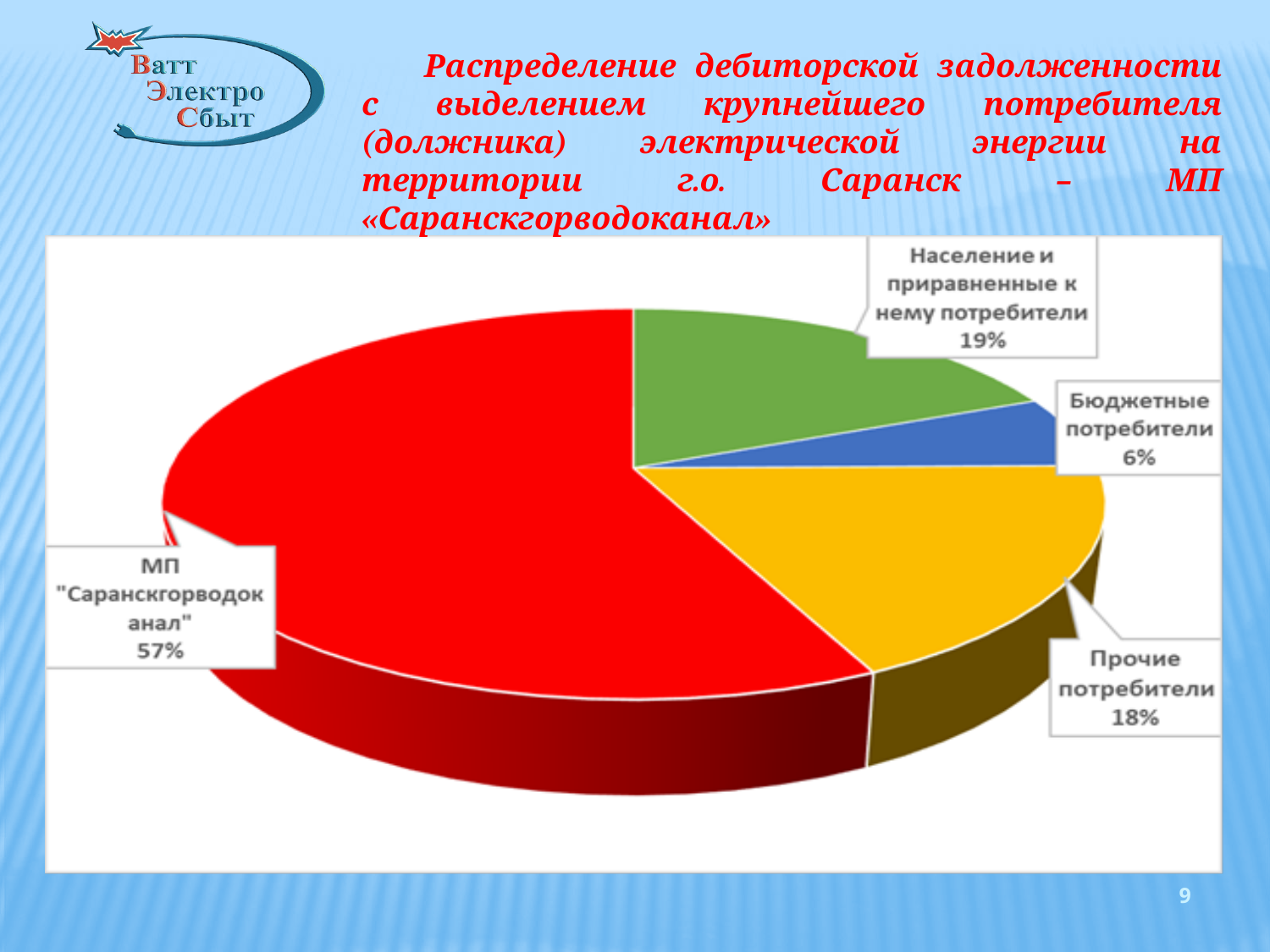
Which category has the largest slice of the pie? МП "Саранскгорводоканал" Which is larger: the share for Население и приравненные к нему потребители or the share for Прочие потребители? Население и приравненные к нему потребители What share of the pie does МП "Саранскгорводоканал" account for? 57% What is the value shown for Население и приравненные к нему потребители? 19% What colour is the slice for МП "Саранскгорводоканал"? Red What kind of chart is shown on the slide? Pie chart What is the value shown for Прочие потребители? 18% What is the difference in percentage points between МП "Саранскгорводоканал" and Прочие потребители? 39 Which category has the smallest slice of the pie? Бюджетные потребители How many slices does the pie chart have? 4 What is the value shown for Бюджетные потребители? 6% What is the difference in percentage points between Население и приравненные к нему потребители and Бюджетные потребители? 13